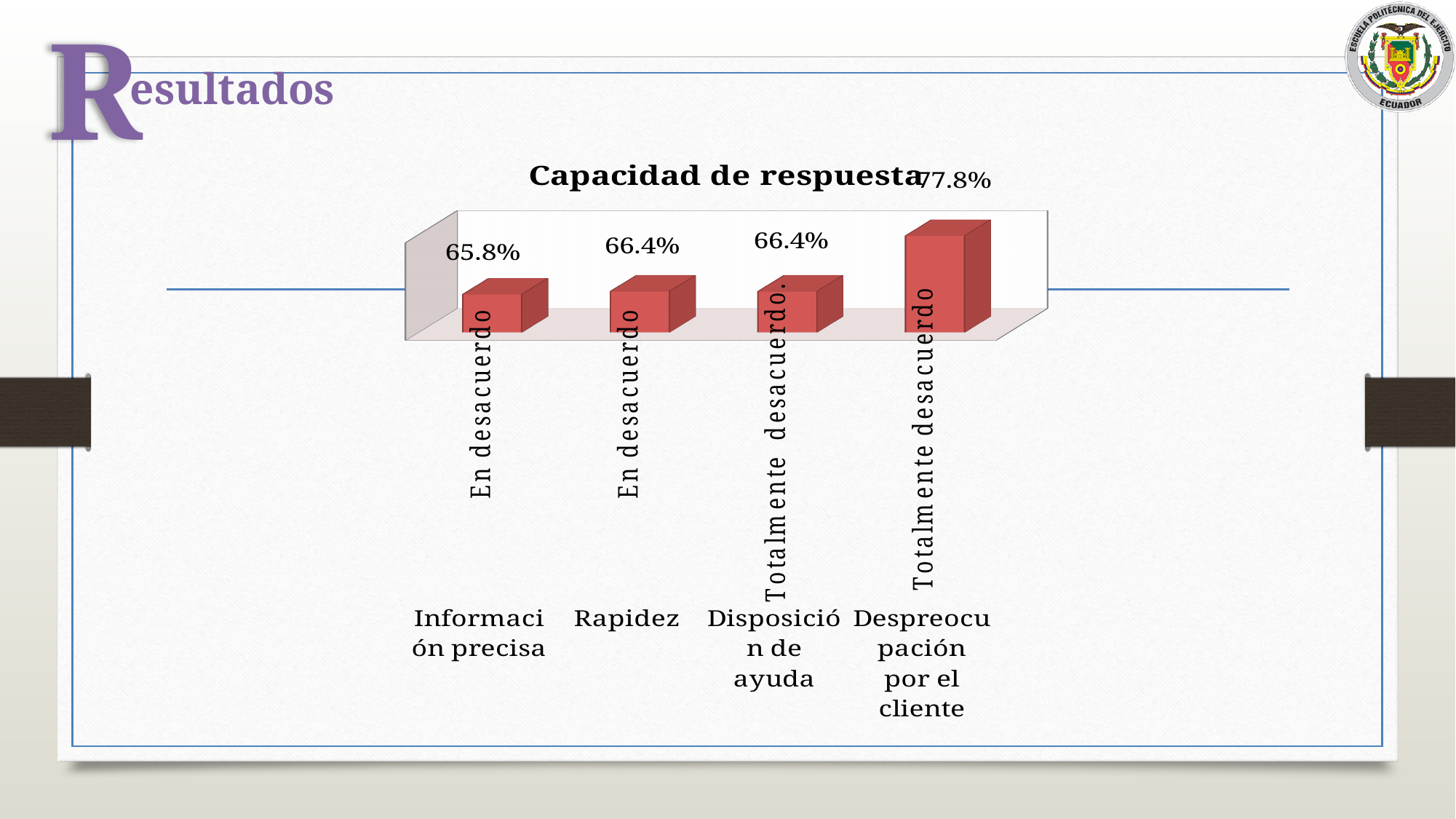
What is the title of the chart? Capacidad de respuesta What is the value for Información precisa in the Capacidad de respuesta chart? 65.8% What is the value for Disposición de ayuda in the Capacidad de respuesta chart? 66.4% What response label is written on the bar for Despreocupación por el cliente? Totalmente desacuerdo What is the difference between the values for Despreocupación por el cliente and Información precisa? 12.0% Which category has the highest value in the Capacidad de respuesta chart? Despreocupación por el cliente What is the value for Despreocupación por el cliente in the Capacidad de respuesta chart? 77.8% What is the value for Rapidez in the Capacidad de respuesta chart? 66.4% Which category has the lowest value in the Capacidad de respuesta chart? Información precisa How many categories are shown in the Capacidad de respuesta chart? 4 Which is larger, the value for Rapidez or the value for Información precisa? Rapidez What kind of chart is shown on the slide? Bar chart